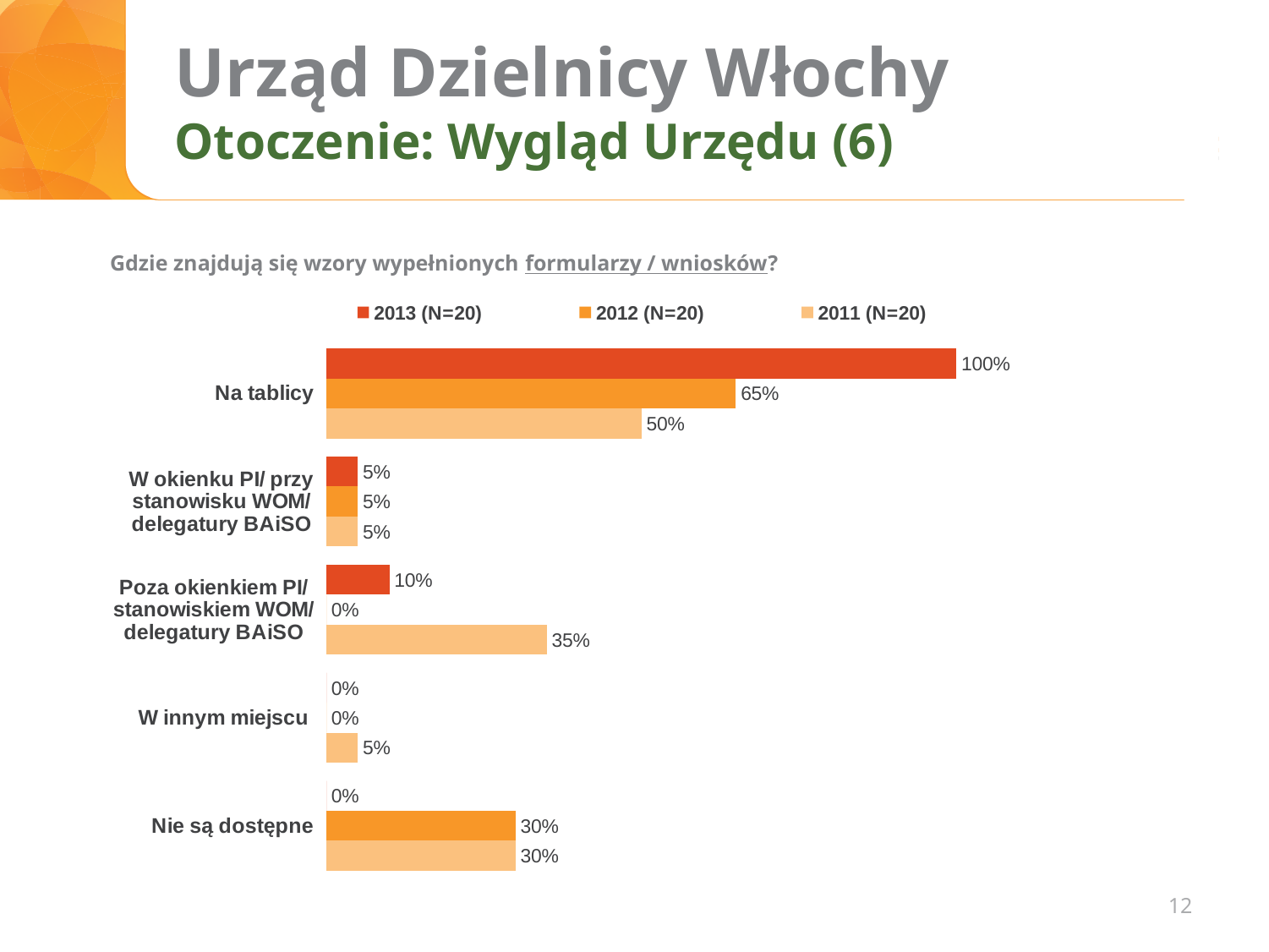
What is the value for 'W innym miejscu' in the 2011 (N=20) series? 5% What is the value for 'Nie są dostępne' in the 2012 (N=20) series? 30% What is the difference between the 2013 (N=20) and 2011 (N=20) values for 'Na tablicy'? 50% Which category has the highest value in the 2013 (N=20) series? Na tablicy What is the value for 'Poza okienkiem PI/ stanowiskiem WOM/ delegatury BAiSO' in the 2011 (N=20) series? 35% What is the value for 'Na tablicy' in the 2013 (N=20) series? 100% What kind of chart is shown on the slide? Bar chart How many categories are shown on the chart? 5 What question does the chart answer, as written above it? Gdzie znajdują się wzory wypełnionych formularzy / wniosków? Which is larger for 'Poza okienkiem PI/ stanowiskiem WOM/ delegatury BAiSO': the 2013 (N=20) value or the 2011 (N=20) value? 2011 (N=20) How many series does the legend list? 3